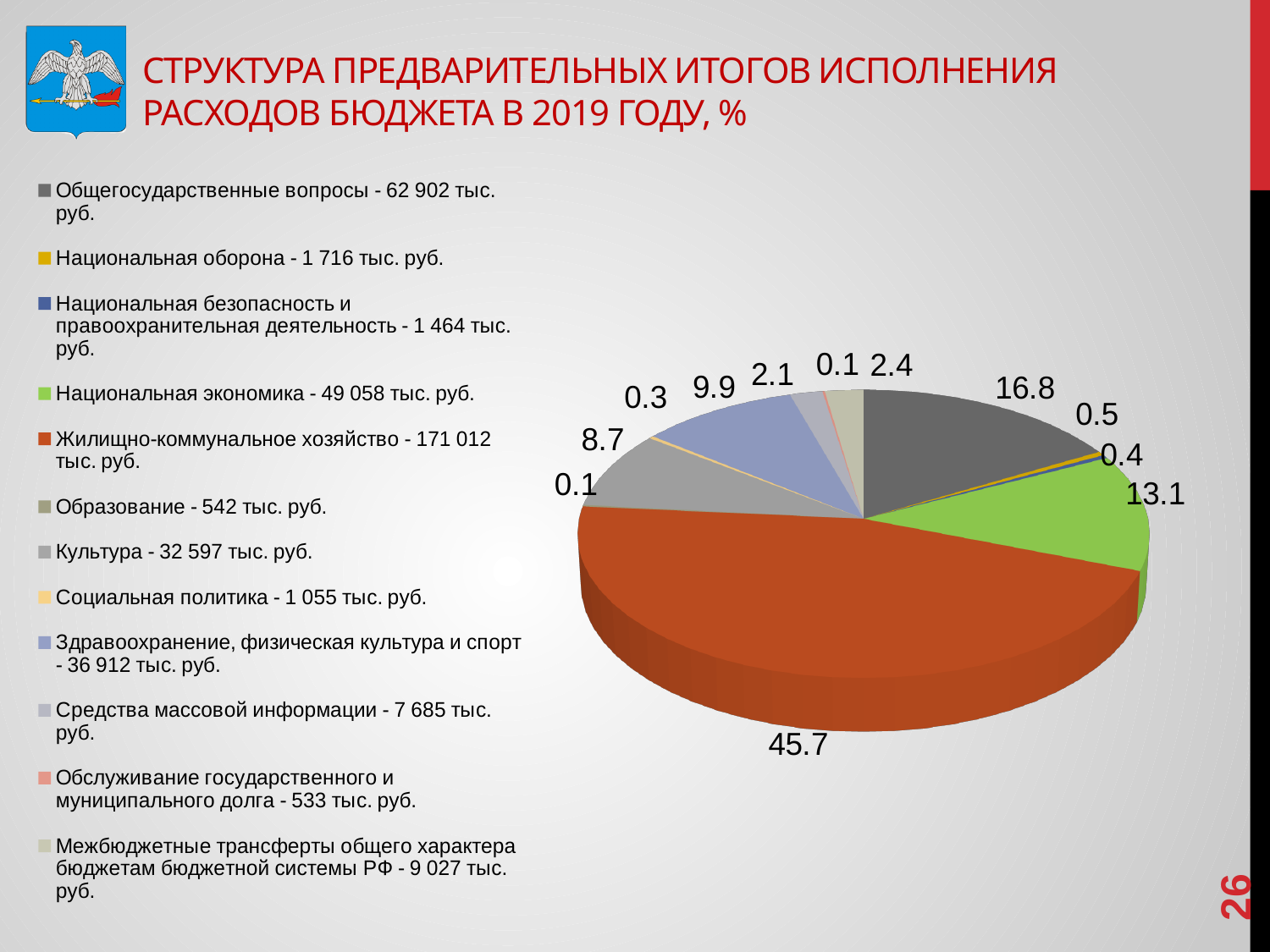
What is the value shown for Межбюджетные трансферты общего характера бюджетам бюджетной системы РФ? 2.4 How many categories does the legend of the pie chart list? 12 Which is larger, the value for Национальная экономика or the value for Здравоохранение, физическая культура и спорт? Национальная экономика What is the difference between the values for Жилищно-коммунальное хозяйство and Общегосударственные вопросы? 28.9 What is the value shown for Культура? 8.7 What amount in thousand rubles does the legend give for Культура? 32 597 тыс. руб. Which category has the largest slice of the pie? Жилищно-коммунальное хозяйство What kind of chart is shown on the slide? pie chart What is the value shown for Жилищно-коммунальное хозяйство? 45.7 What is the value shown for Общегосударственные вопросы? 16.8 What is the value shown for Здравоохранение, физическая культура и спорт? 9.9 What is the value shown for Национальная экономика? 13.1